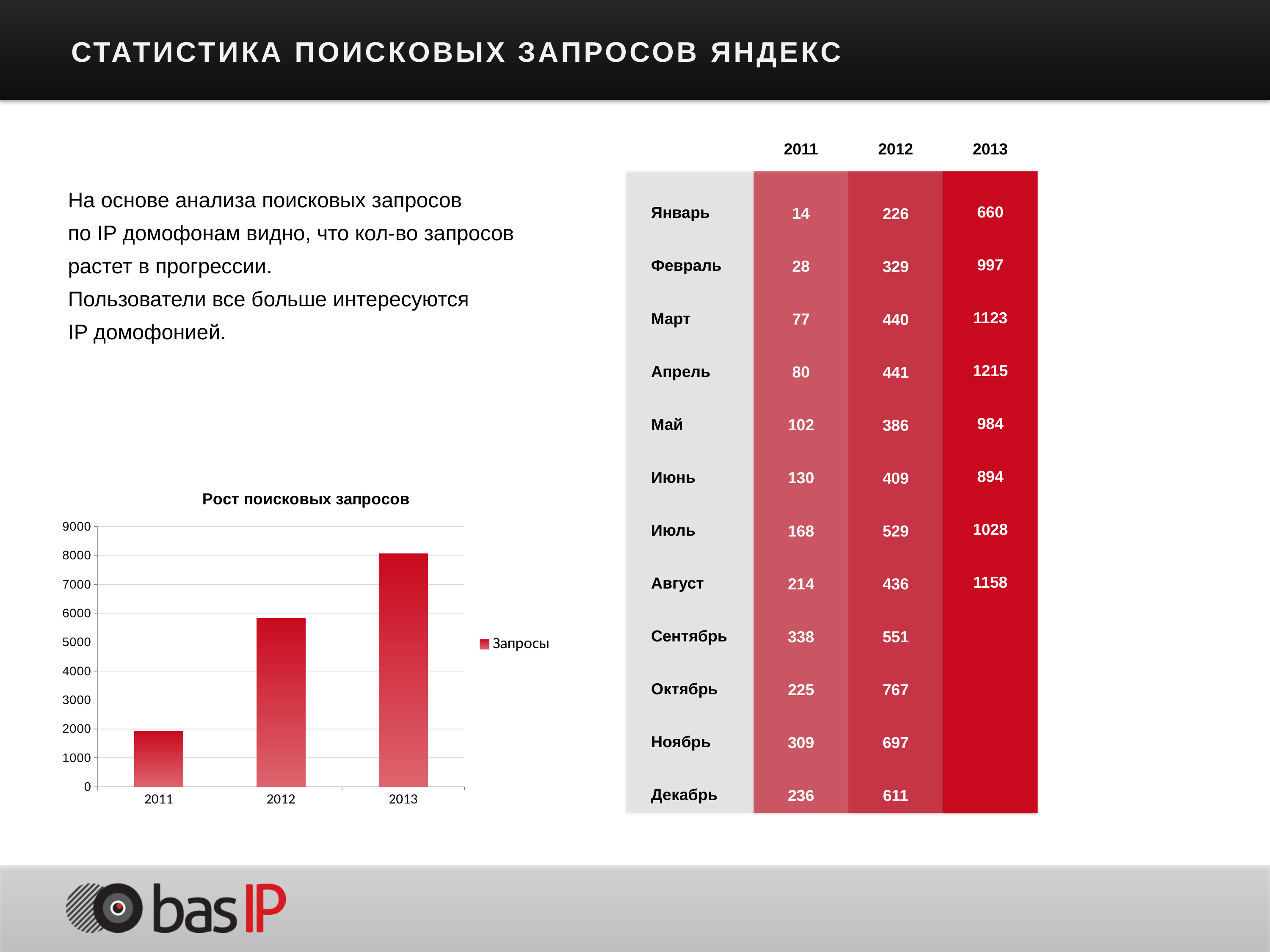
How many categories are shown on the x axis of the chart? 3 Do the values in the chart rise or fall from 2011 to 2013? rise Which is larger in the chart, the value for 2011 or the value for 2012? 2012 Which year has the highest value in the chart? 2013 Which year has the lowest value in the chart? 2011 Is the value for 2012 greater or less than 5000? greater What is the title of the chart? Рост поисковых запросов Is the value for 2013 greater or less than 7000? greater Is the value for 2011 greater or less than 1000? greater What kind of chart is shown on the slide? bar chart What is the name of the series in the chart legend? Запросы How many series does the chart legend list? 1